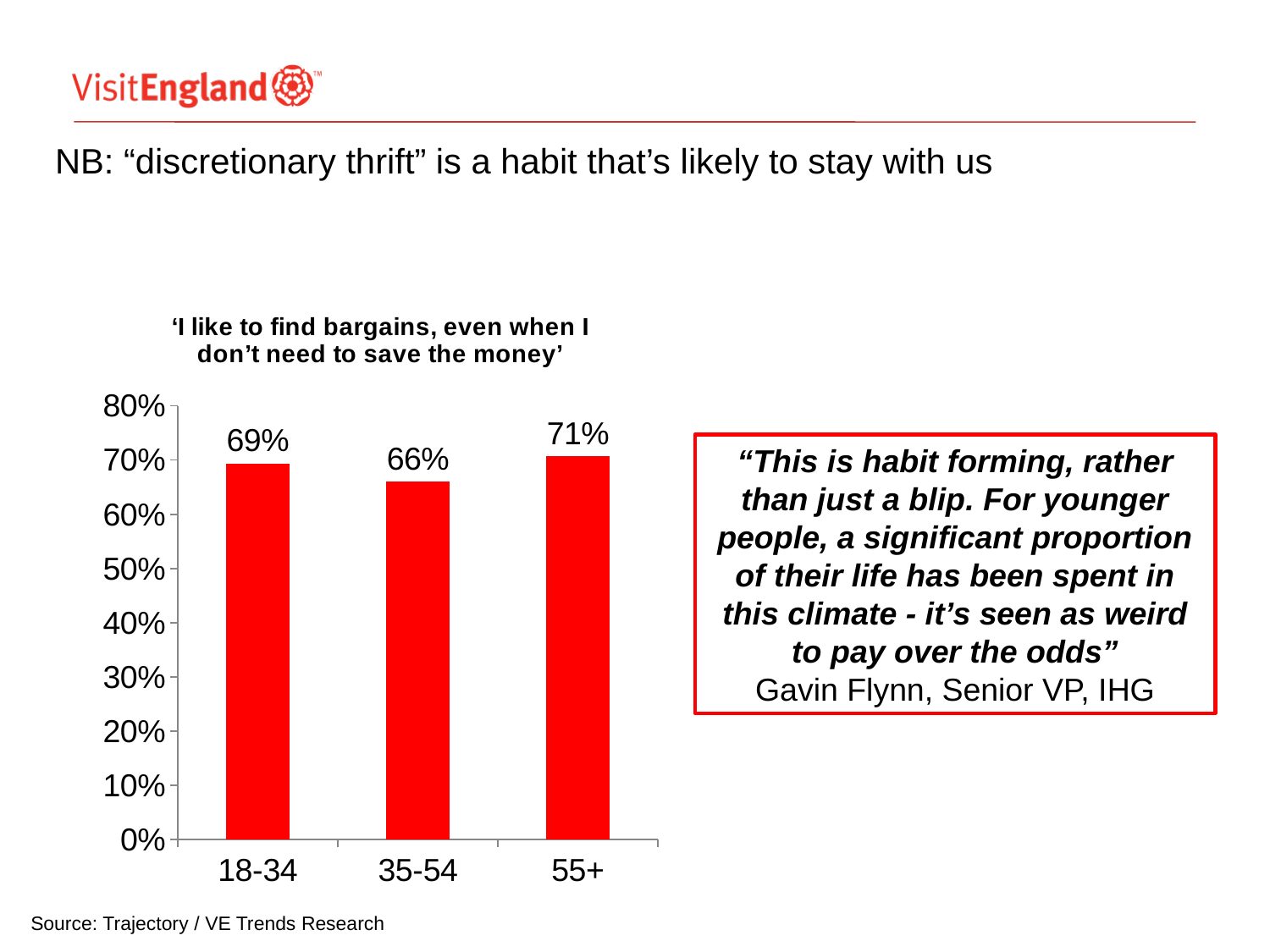
What percentage of the 18-34 age group agree with 'I like to find bargains, even when I don't need to save the money'? 69% What is the difference between the values for the 18-34 and 35-54 age groups? 3% What is the value shown for the 35-54 age group? 66% Which age group has the lowest value in the chart? 35-54 What is the title of the chart? 'I like to find bargains, even when I don't need to save the money' Is the value for the 35-54 age group greater or less than 70%? less Which age group has the highest value in the chart? 55+ What is the difference between the values for the 55+ and 35-54 age groups? 5% What type of chart is shown on the slide? Bar chart How many age groups are shown in the chart? 3 Which is larger, the value for 18-34 or the value for 55+? 55+ What is the value shown for the 55+ age group? 71%